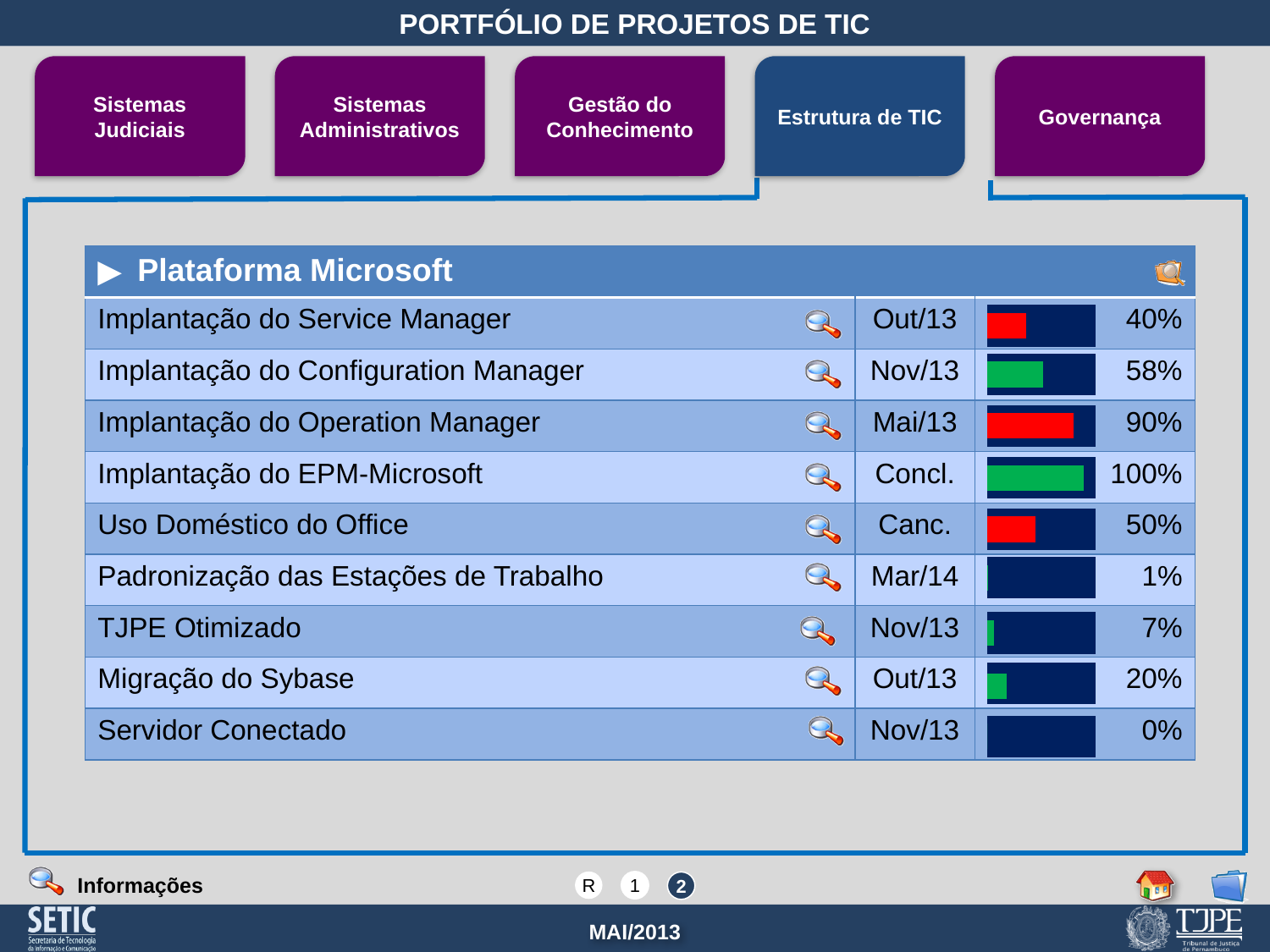
What is the difference in progress percentage between Implantação do Operation Manager and Implantação do Service Manager? 50% What is the progress percentage shown for Migração do Sybase? 20% What is the progress percentage shown for Implantação do Configuration Manager? 58% What is the progress percentage shown for Implantação do Service Manager? 40% Which project in the Plataforma Microsoft table has the lowest progress percentage? Servidor Conectado Which has a higher progress percentage, Uso Doméstico do Office or Implantação do Configuration Manager? Implantação do Configuration Manager What colour is the progress bar for Implantação do Operation Manager? Red What is the title of the table containing the progress bars? Plataforma Microsoft Which project in the Plataforma Microsoft table has the highest progress percentage? Implantação do EPM-Microsoft What is the progress percentage shown for TJPE Otimizado? 7% How many projects are listed in the Plataforma Microsoft table? 9 What kind of chart is used to show the progress of each project? Bar chart